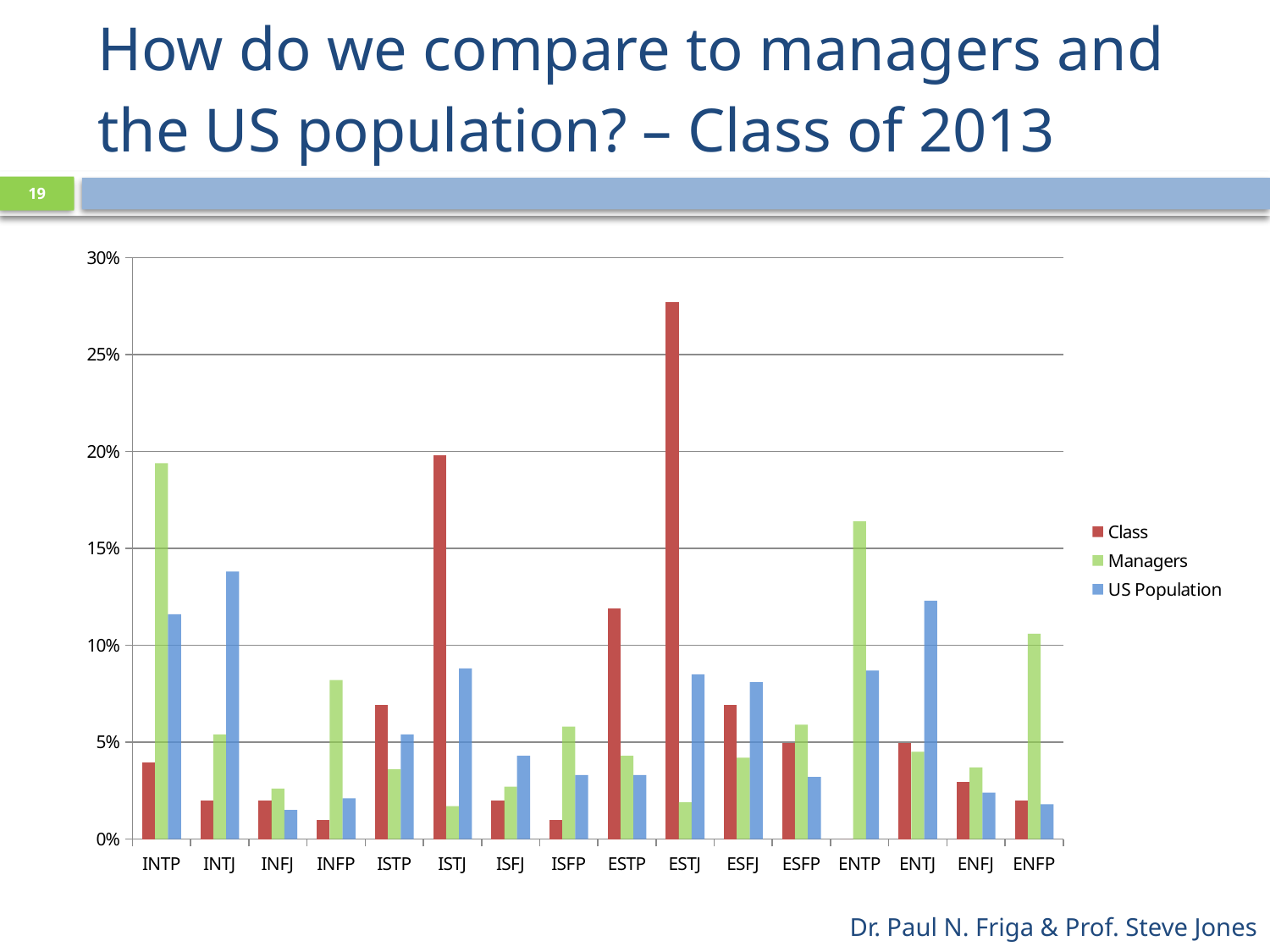
Is the Managers value for ENTP greater or less than 15%? greater Which category has the highest value for the US Population series? INTJ Is the US Population value for INTJ greater or less than 15%? less Which category has the highest value for the Class series? ESTJ Which series is shown in red in the legend? Class Is the Class value for ESTJ greater or less than 25%? greater Which category has the highest value for the Managers series? INTP How many series does the legend list? 3 How many personality type categories are shown on the x axis? 16 What kind of chart is shown on the slide? bar chart For INTP, which is larger: the Class value or the Managers value? Managers